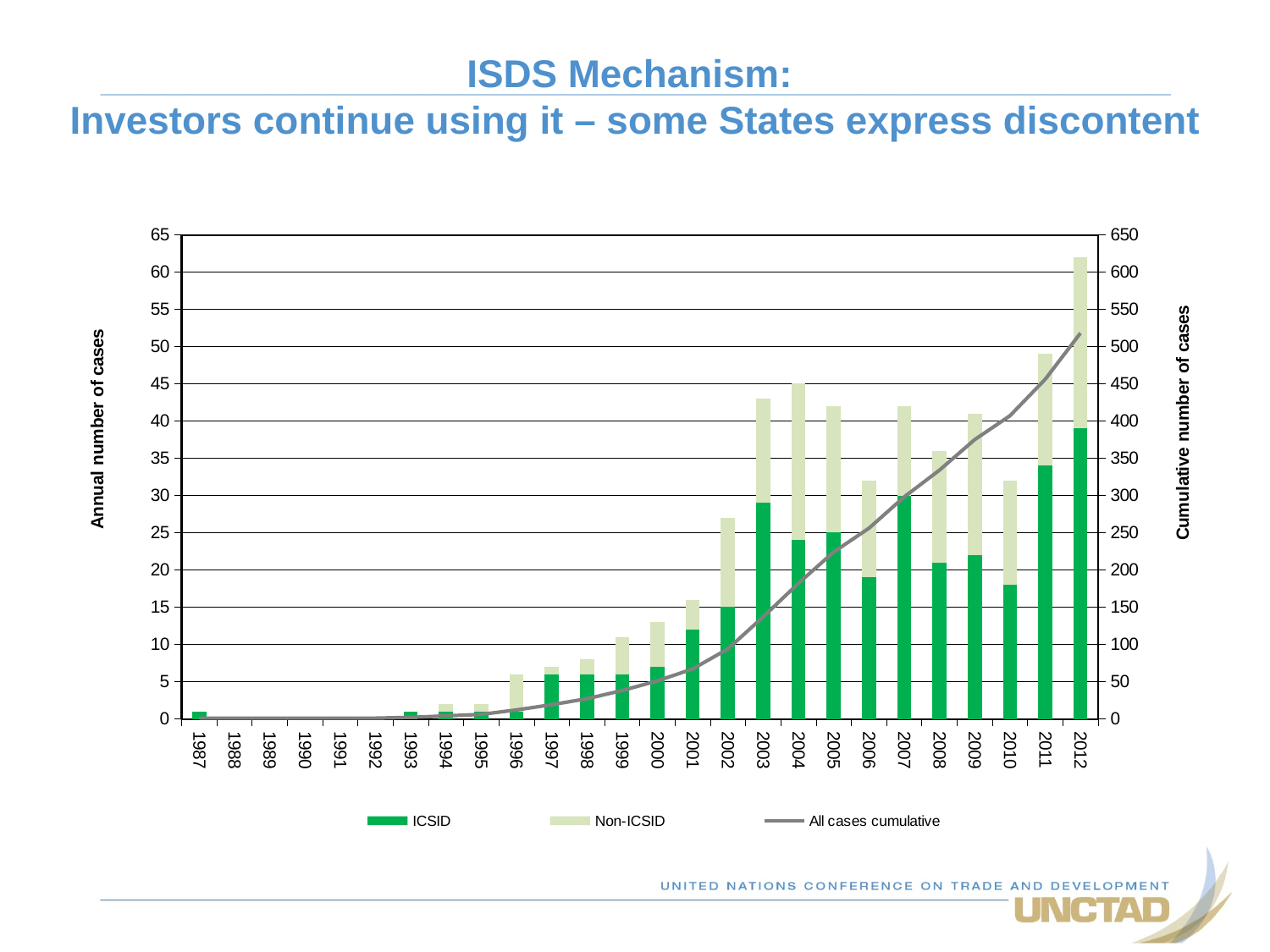
Is the total annual number of cases in 2006 greater or less than 35? less What is the title of the left vertical axis? Annual number of cases Is the cumulative number of cases in 2005 greater or less than 200? greater Which year has the larger total annual number of cases, 2003 or 2006? 2003 Is the ICSID value for 2012 greater or less than 35? greater How many years are shown on the x axis? 26 Does the 'All cases cumulative' line rise or fall from 1987 to 2012? rise Which year has the larger ICSID value, 2003 or 2004? 2003 Which year has the highest total annual number of cases? 2012 How many series does the legend list? 3